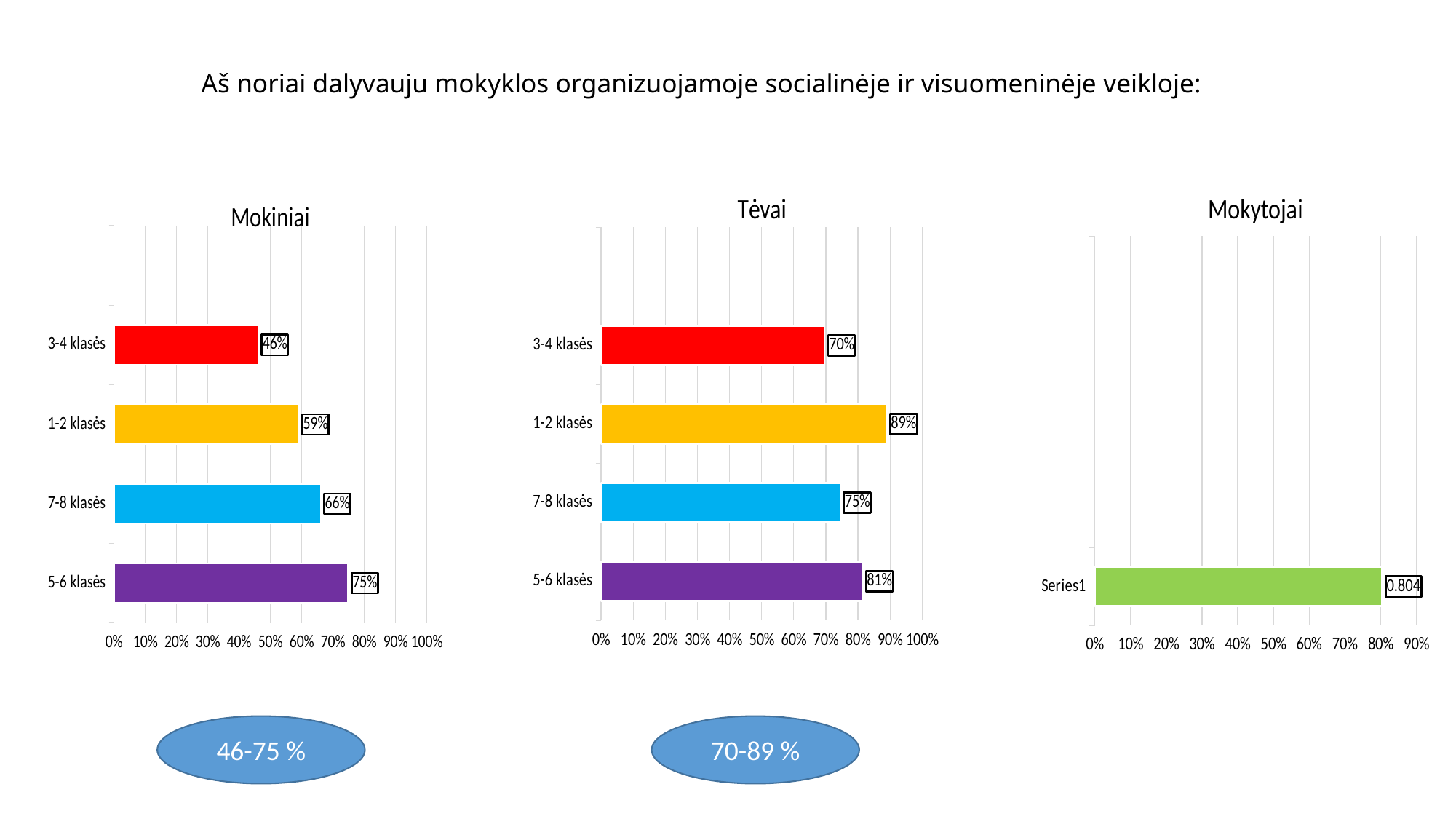
In the Tėvai chart, which is larger: the value for 7-8 klasės or the value for 5-6 klasės? 5-6 klasės In the Mokiniai chart, what colour is the bar for 1-2 klasės? yellow In the Tėvai chart, what is the value for 1-2 klasės? 89% How many categories are shown in the Tėvai chart? 4 In the Mokiniai chart, what is the difference between the values for 5-6 klasės and 3-4 klasės? 29% In the Mokiniai chart, which category has the lowest value? 3-4 klasės In the Mokiniai chart, what is the value for 3-4 klasės? 46% In the Tėvai chart, which category has the lowest value? 3-4 klasės What kind of chart is the Mokiniai chart? bar chart In the Mokiniai chart, which category has the highest value? 5-6 klasės In the Mokytojai chart, what is the value shown for Series1? 0.804 In the Tėvai chart, what is the difference between the values for 1-2 klasės and 7-8 klasės? 14%